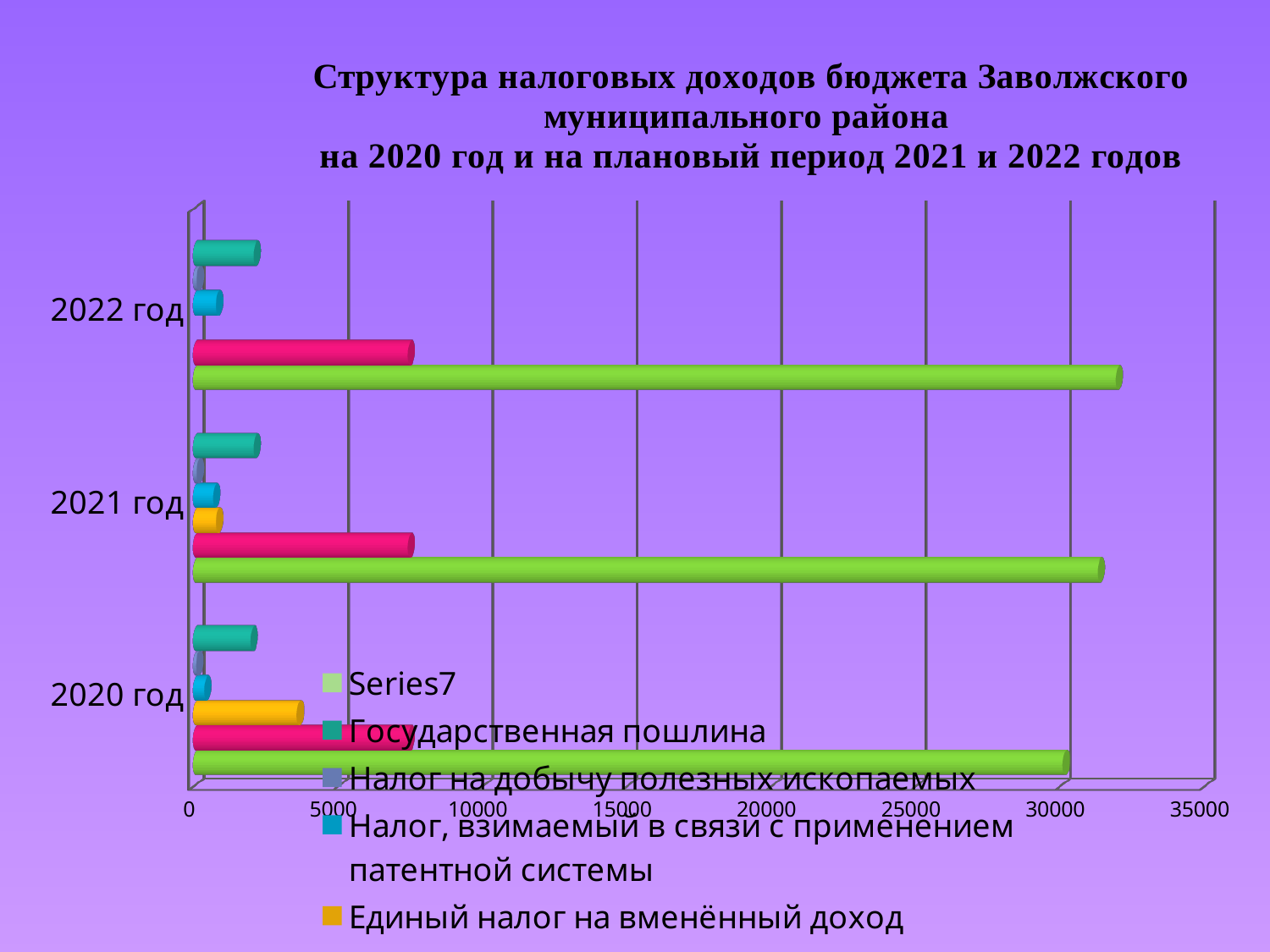
What kind of chart is shown on the slide? bar chart Is the value of Государственная пошлина for 2022 год greater or less than 5000? less How many year categories are shown on the vertical axis? 3 How many series does the visible legend list? 5 Which is larger for 2020 год: Единый налог на вменённый доход or Государственная пошлина? Единый налог на вменённый доход What is the highest value shown on the horizontal axis? 35000 Which is larger for 2022 год: Государственная пошлина or Налог, взимаемый в связи с применением патентной системы? Государственная пошлина Is the value of Единый налог на вменённый доход for 2020 год greater or less than 5000? less